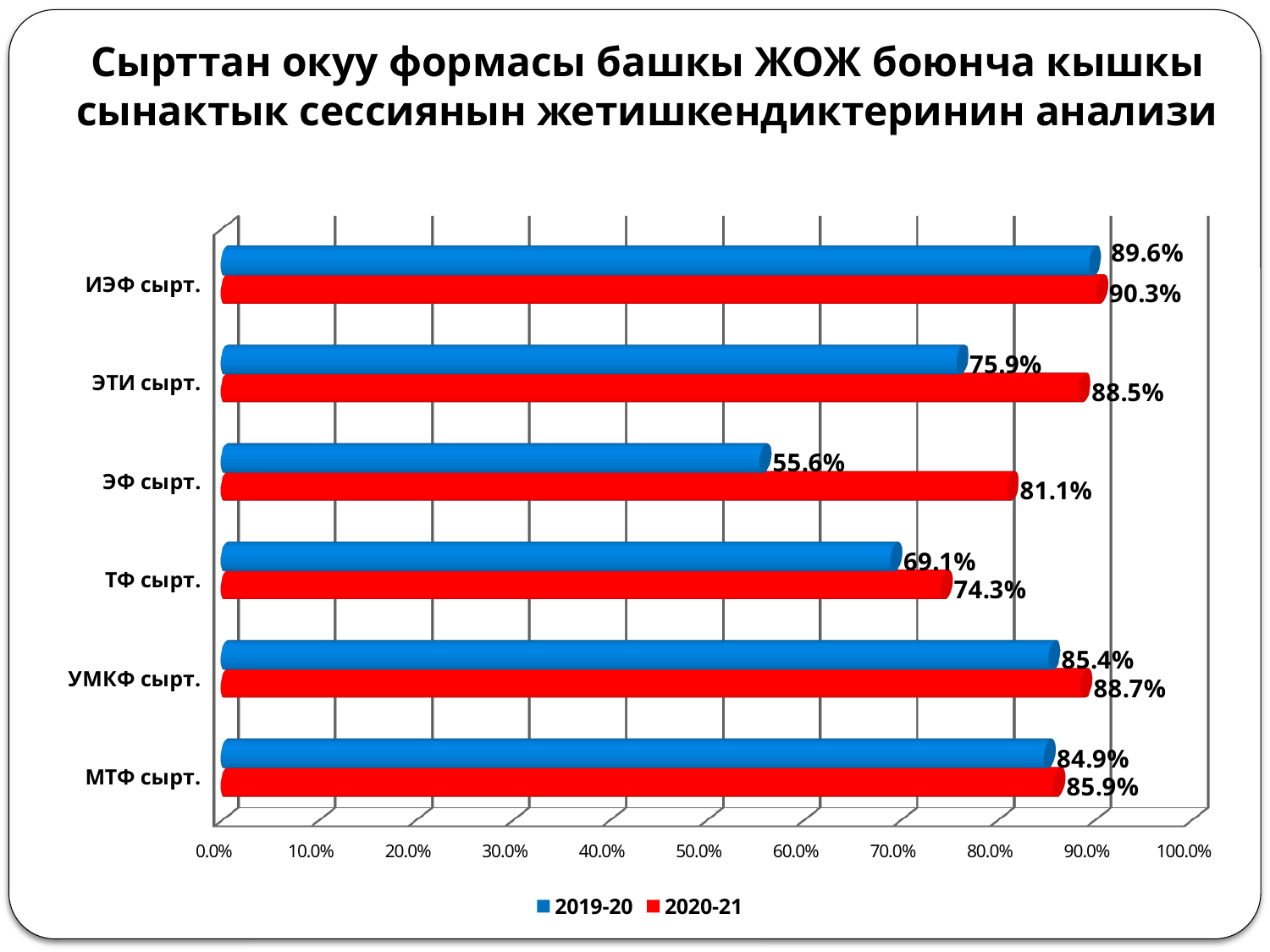
What colour are the bars for the 2020-21 series? Red Which category has the lowest value in the 2019-20 series? ЭФ сырт. Which category has the highest value in the 2020-21 series? ИЭФ сырт. What is the difference between the 2020-21 and 2019-20 values for ЭФ сырт.? 25.5% What is the value for ЭФ сырт. in the 2019-20 series? 55.6% How many series does the legend list? 2 What is the difference between the 2020-21 and 2019-20 values for ЭТИ сырт.? 12.6% What is the value for ТФ сырт. in the 2020-21 series? 74.3% How many categories are shown on the chart? 6 Which is larger for ТФ сырт.: the 2019-20 value or the 2020-21 value? 2020-21 What is the value for ЭТИ сырт. in the 2020-21 series? 88.5% What kind of chart is shown on the slide? Bar chart